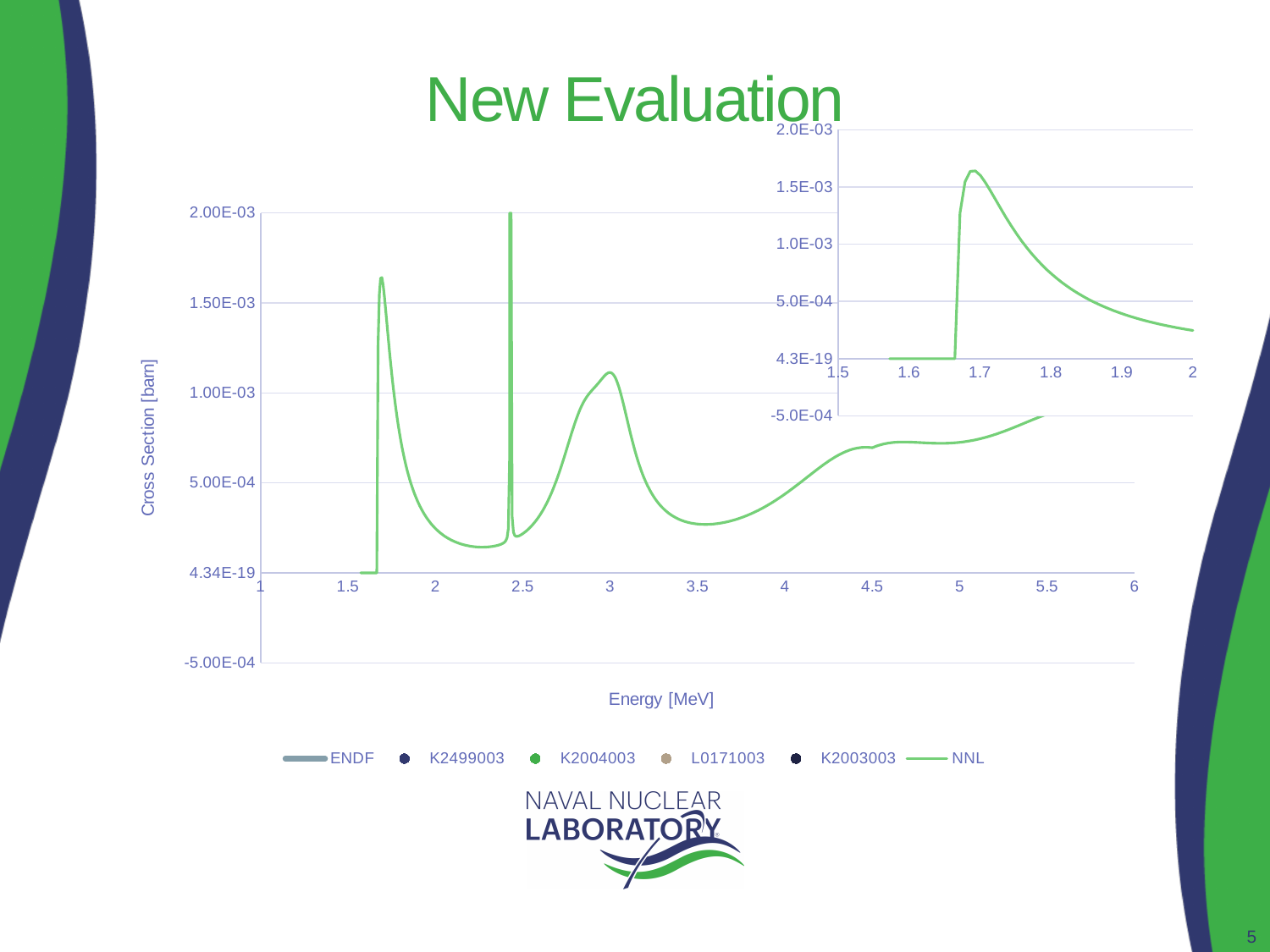
What is the x-axis label of the main chart? Energy [MeV] In the main chart, do the NNL values rise or fall between 3 MeV and 3.5 MeV? fall In the inset chart at the top right, do the values rise or fall between 1.7 MeV and 2 MeV? fall In the main chart, do the NNL values rise or fall between 4 MeV and 5.5 MeV? rise How many series does the legend of the main chart list? 6 In the main chart, is the NNL value at 3.5 MeV greater or less than 5.00E-04? less In the main chart, is the NNL value at 5 MeV greater or less than 1.00E-03? less In the inset chart at the top right, is the peak value greater or less than 1.5E-03? greater What type of chart is the main chart on the slide? line chart